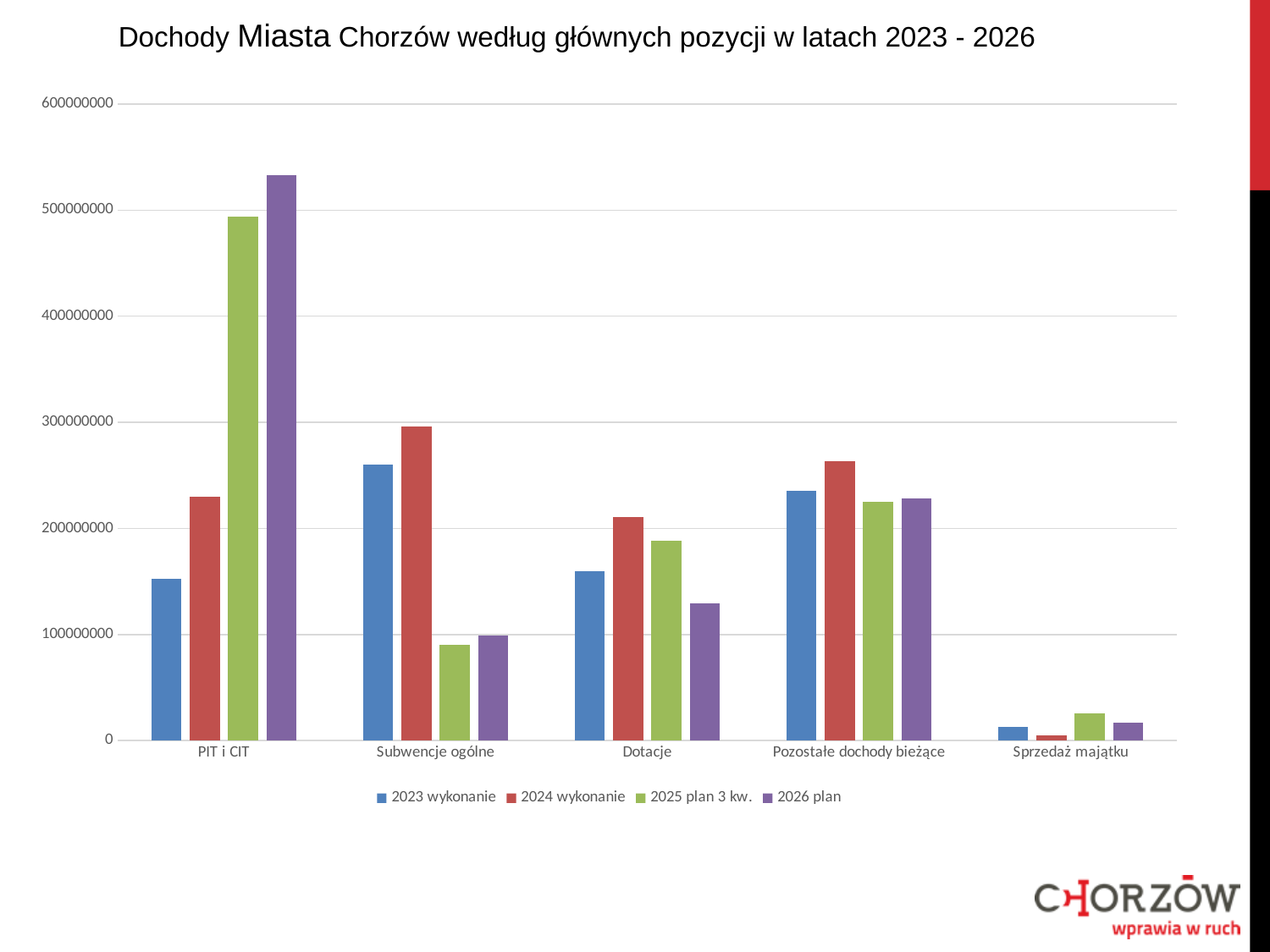
Is the 2024 wykonanie value for Pozostałe dochody bieżące greater or less than 200000000? greater Is the 2025 plan 3 kw. value for Subwencje ogólne greater or less than 100000000? less For Subwencje ogólne, which is larger: 2023 wykonanie or 2024 wykonanie? 2024 wykonanie Which category has the lowest 2024 wykonanie bar? Sprzedaż majątku What is the title of the chart? Dochody Miasta Chorzów według głównych pozycji w latach 2023 - 2026 How many series does the legend list? 4 What kind of chart is shown on the slide? bar chart How many categories are shown on the x axis? 5 Which category has the highest 2026 plan bar? PIT i CIT For PIT i CIT, do the values rise or fall from 2023 wykonanie to 2026 plan? rise Is the 2026 plan value for PIT i CIT greater or less than 500000000? greater For Dotacje, which is larger: 2025 plan 3 kw. or 2026 plan? 2025 plan 3 kw.